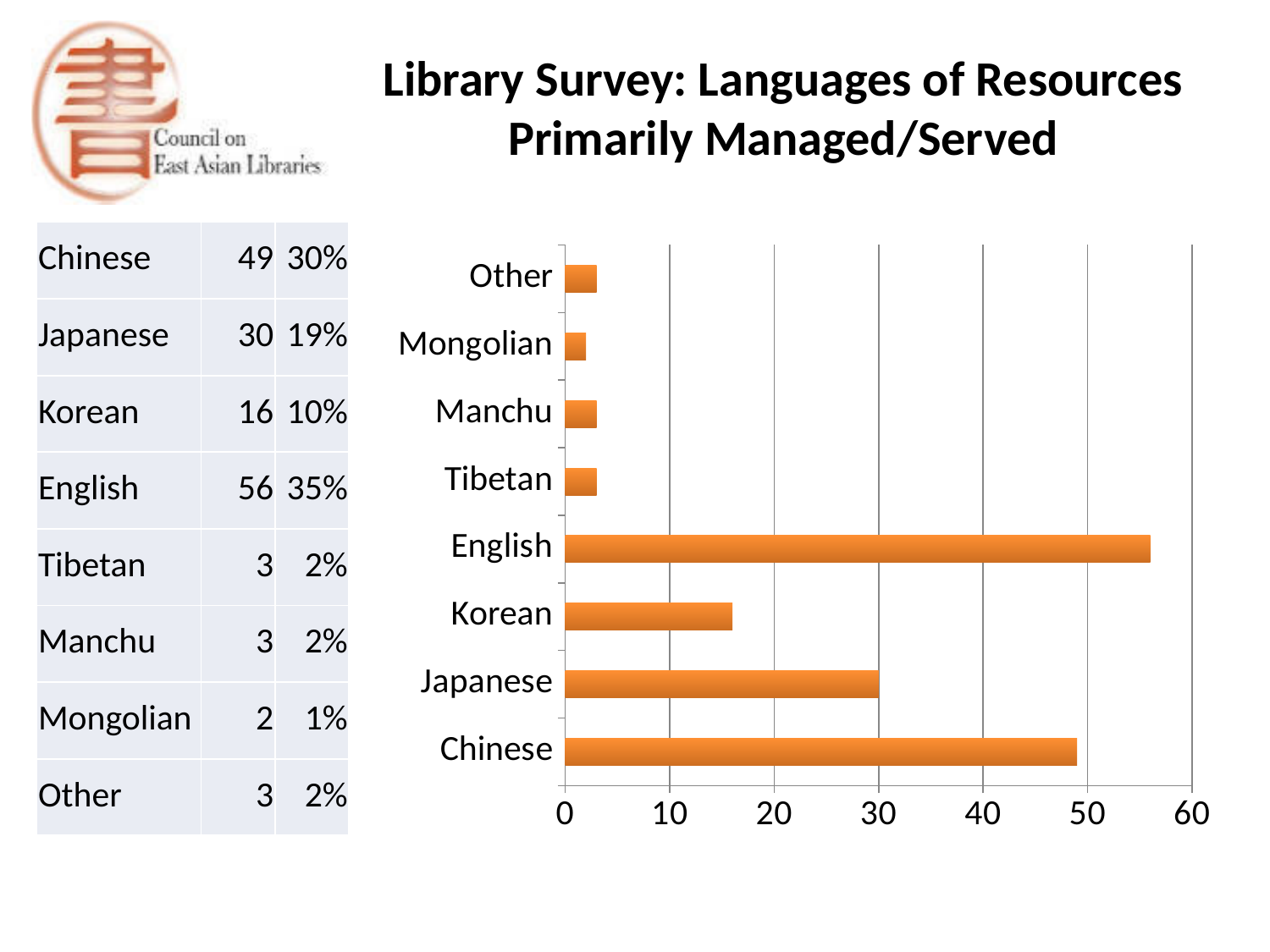
Which language has the highest value in the chart? English Is the value for Chinese greater or less than 40? greater How many categories does the bar chart show? 8 What percentage share does the table give for English? 35% What is the difference between the values for Japanese and Korean? 14 Which language has the lowest value in the chart? Mongolian Which is larger, the value for Japanese or the value for Korean? Japanese What kind of chart is shown on the slide? bar chart What is the value for Chinese? 49 What is the difference between the values for English and Chinese? 7 What is the value for English? 56 What is the value for Korean? 16